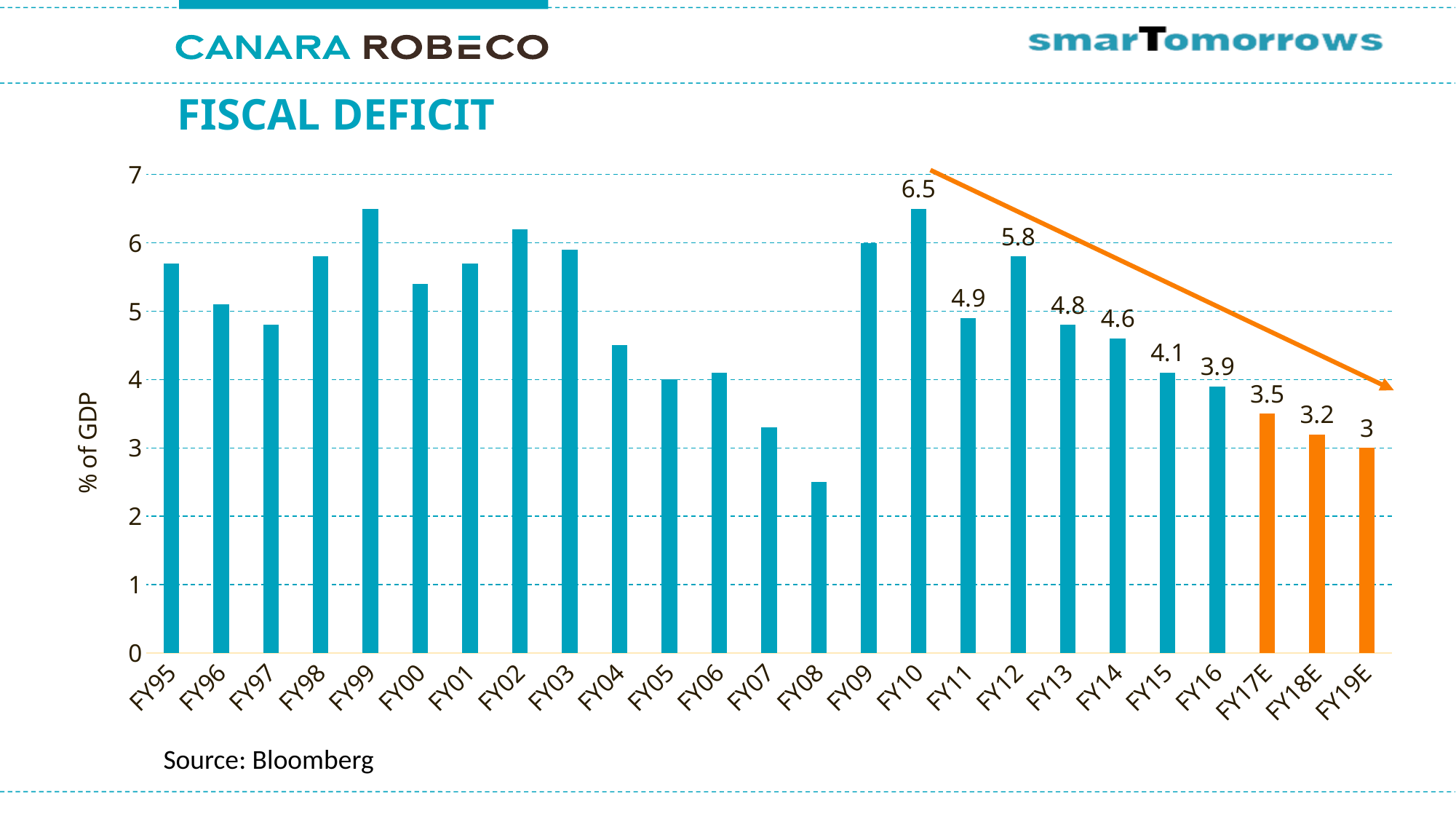
What is the difference between the fiscal deficit values for FY10 and FY19E? 3.5 What is the fiscal deficit value for FY10? 6.5 What is the difference between the fiscal deficit values for FY12 and FY11? 0.9 Which fiscal year has the lowest fiscal deficit? FY08 Is the fiscal deficit value for FY08 greater or less than 3? less Is the fiscal deficit value for FY99 greater or less than 6? greater How many fiscal years are shown on the x axis? 25 What kind of chart is used to show the fiscal deficit? Bar chart What is the fiscal deficit value for FY14? 4.6 What is the fiscal deficit value for FY19E? 3 Which is larger, the fiscal deficit for FY12 or for FY13? FY12 Do the fiscal deficit values rise or fall from FY10 to FY19E? Fall